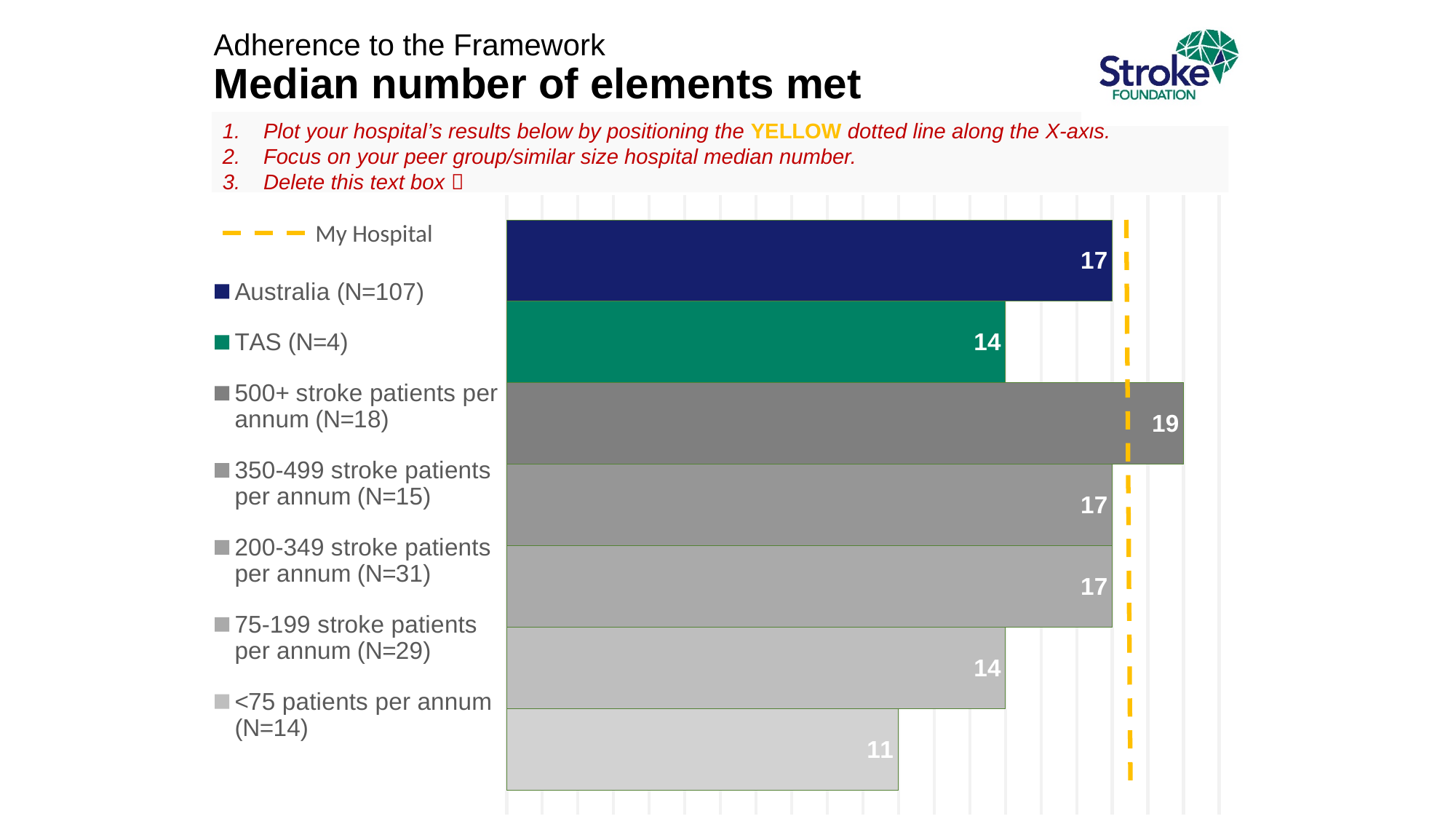
Which is larger: the median for Australia (N=107) or the median for TAS (N=4)? Australia (N=107) What colour is the dotted 'My Hospital' line in the chart? Yellow What is the median number of elements met for Australia (N=107)? 17 What is the median number of elements met for hospitals with 75-199 stroke patients per annum (N=29)? 14 What is the median number of elements met for TAS (N=4)? 14 How many bars are plotted in the chart? 7 Which group has the lowest median number of elements met? <75 patients per annum (N=14) What is the difference between the median for 500+ stroke patients per annum and the median for <75 patients per annum? 8 What is the median number of elements met for hospitals with 500+ stroke patients per annum (N=18)? 19 Which group has the highest median number of elements met? 500+ stroke patients per annum (N=18) What is the median number of elements met for hospitals with <75 patients per annum (N=14)? 11 What kind of chart is shown on the slide? Bar chart